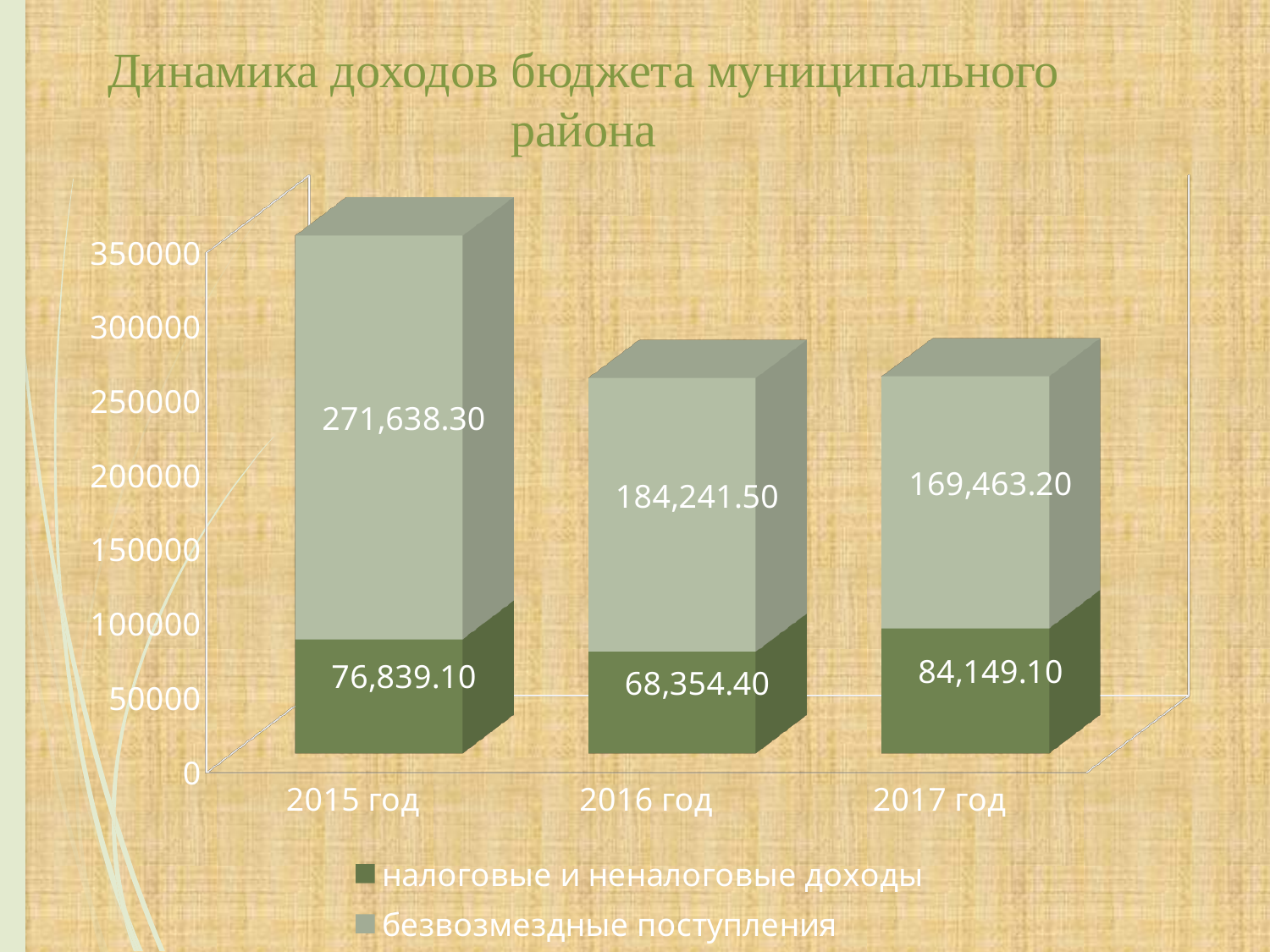
What is the difference between безвозмездные поступления in 2015 год and 2016 год? 87,396.80 In which year is the value of налоговые и неналоговые доходы highest? 2017 год What kind of chart is shown on the slide? Stacked bar chart What is the value of безвозмездные поступления for 2015 год? 271,638.30 How many series does the legend list? 2 In which year is the value of безвозмездные поступления lowest? 2017 год How many years are shown on the x axis? 3 What is the value of безвозмездные поступления for 2017 год? 169,463.20 What is the total of the stacked bar for 2015 год? 348,477.40 What is the total of the stacked bar for 2016 год? 252,595.90 What is the value of налоговые и неналоговые доходы for 2016 год? 68,354.40 Which is larger: налоговые и неналоговые доходы in 2015 год or in 2016 год? 2015 год